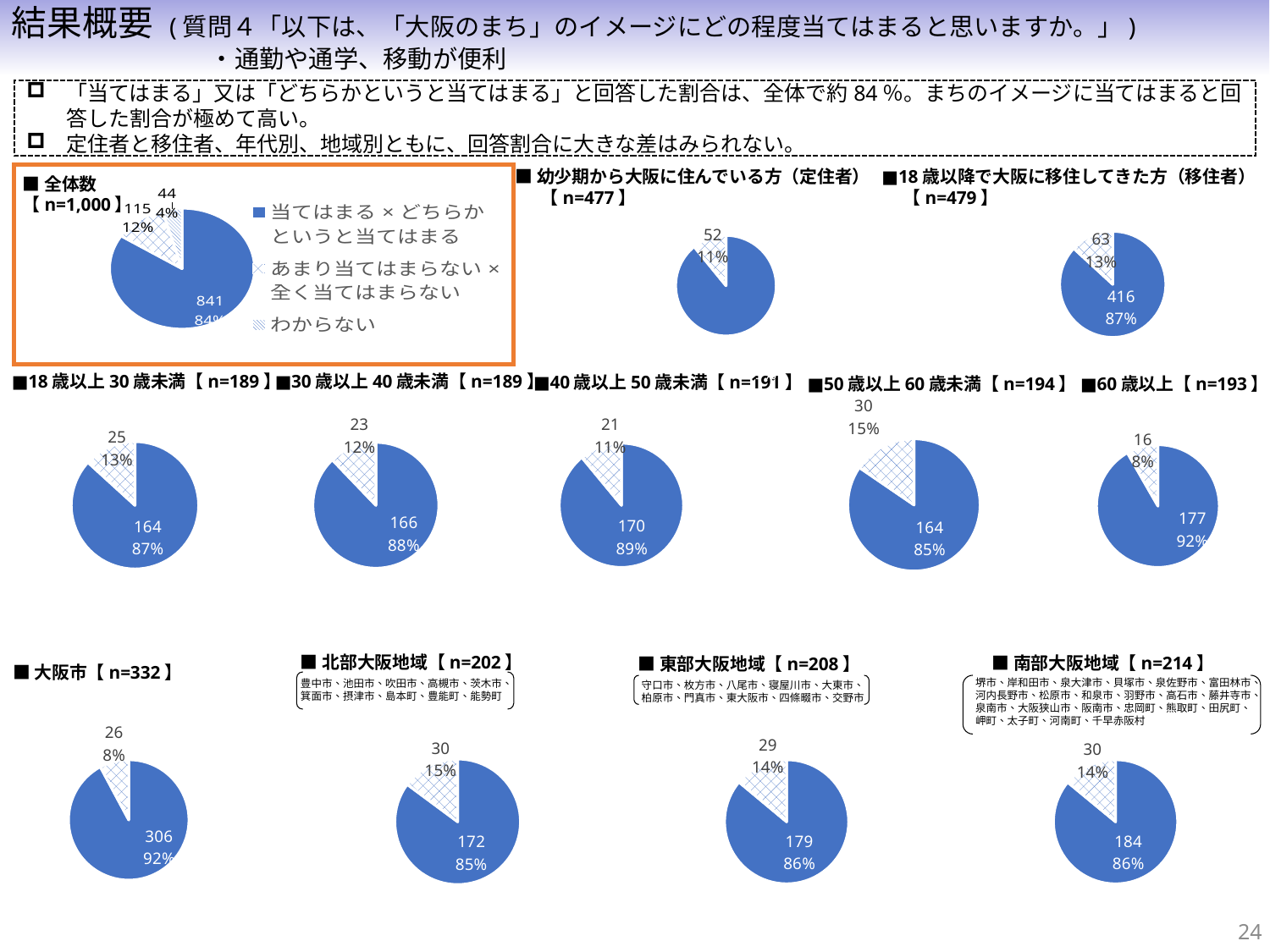
「60歳以上【n=193】」の円グラフで、「当てはまる×どちらかというと当てはまる」の割合は何%ですか。 92% 「全体数【n=1,000】」の円グラフで、「わからない」の件数はいくつですか。 44 「幼少期から大阪に住んでいる方（定住者）【n=477】」の円グラフで、「あまり当てはまらない×全く当てはまらない」の割合は何%ですか。 11% 「大阪市【n=332】」の円グラフで、「当てはまる×どちらかというと当てはまる」の件数はいくつですか。 306 「北部大阪地域【n=202】」と「東部大阪地域【n=208】」の円グラフで、「当てはまる×どちらかというと当てはまる」の割合が大きいのはどちらですか。 東部大阪地域 「50歳以上60歳未満【n=194】」の円グラフで、「あまり当てはまらない×全く当てはまらない」の件数はいくつですか。 30 「18歳以上30歳未満【n=189】」と「30歳以上40歳未満【n=189】」の円グラフで、「当てはまる×どちらかというと当てはまる」の件数の差はいくつですか。 2 「全体数【n=1,000】」の円グラフで、「当てはまる×どちらかというと当てはまる」の割合は何%ですか。 84% 「南部大阪地域【n=214】」の円グラフで、「あまり当てはまらない×全く当てはまらない」の割合は何%ですか。 14% 「18歳以降で大阪に移住してきた方（移住者）【n=479】」の円グラフで、最も大きい区分の件数はいくつですか。 416 「全体数【n=1,000】」の円グラフの凡例には、いくつの項目がありますか。 3 このスライドのグラフはどの種類のグラフですか。 円グラフ